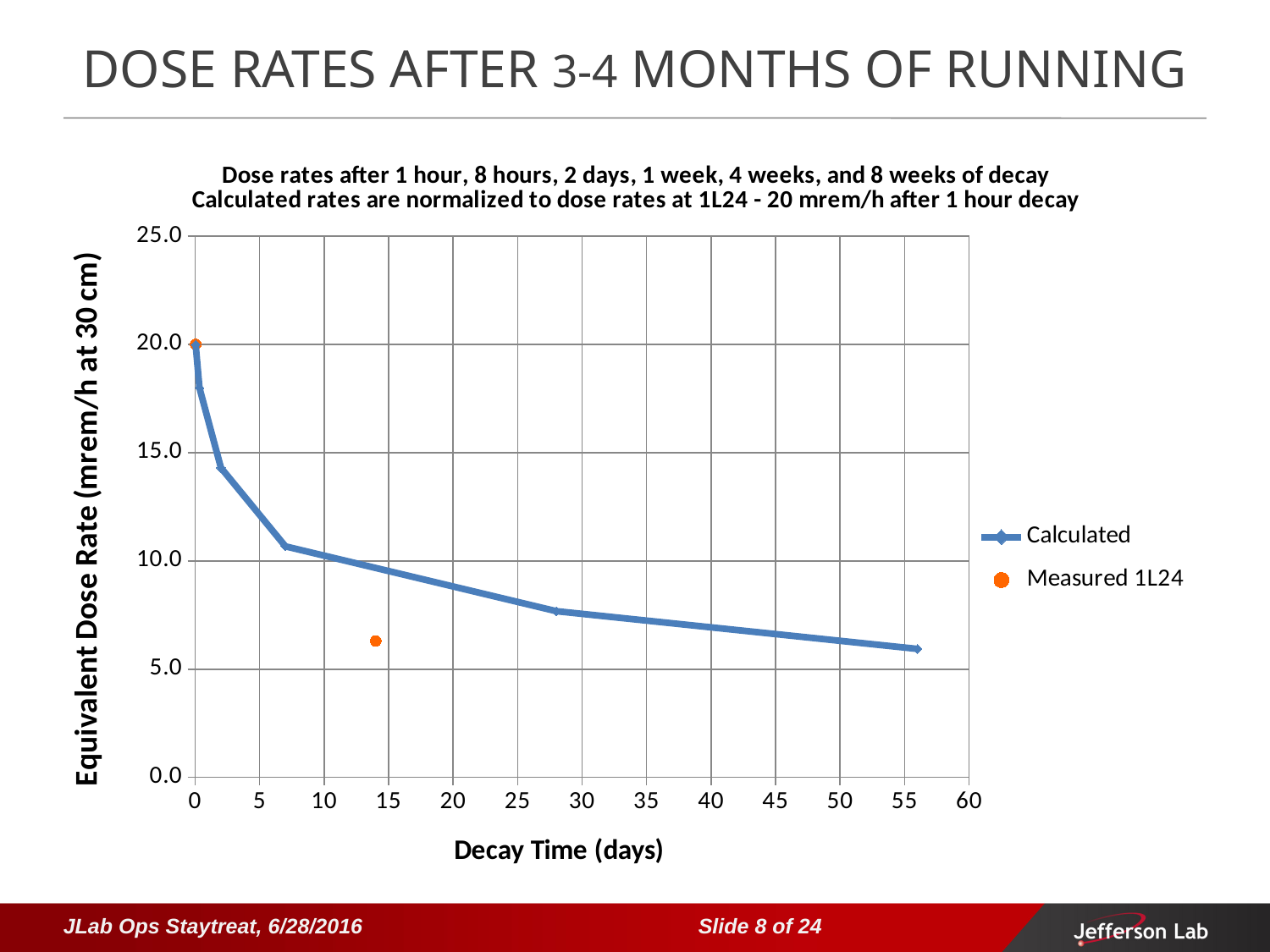
What kind of chart is shown on the slide? line chart How many decay times are listed in the chart title? 6 What is the label of the x axis? Decay Time (days) Is the Calculated value at 2 days greater or less than 10.0? greater Is the Measured 1L24 value at about 14 days greater or less than 10.0? less What are the two series named in the legend? Calculated and Measured 1L24 How many Measured 1L24 points are plotted? 2 According to the chart subtitle, what dose rate at 1L24 after 1 hour decay are the calculated rates normalized to? 20 mrem/h How many series does the legend list? 2 Does the Calculated dose rate rise or fall as decay time increases? fall At about 14 days of decay, which is higher: the Calculated curve or the Measured 1L24 point? Calculated Is the Calculated value at 56 days greater or less than 10.0? less